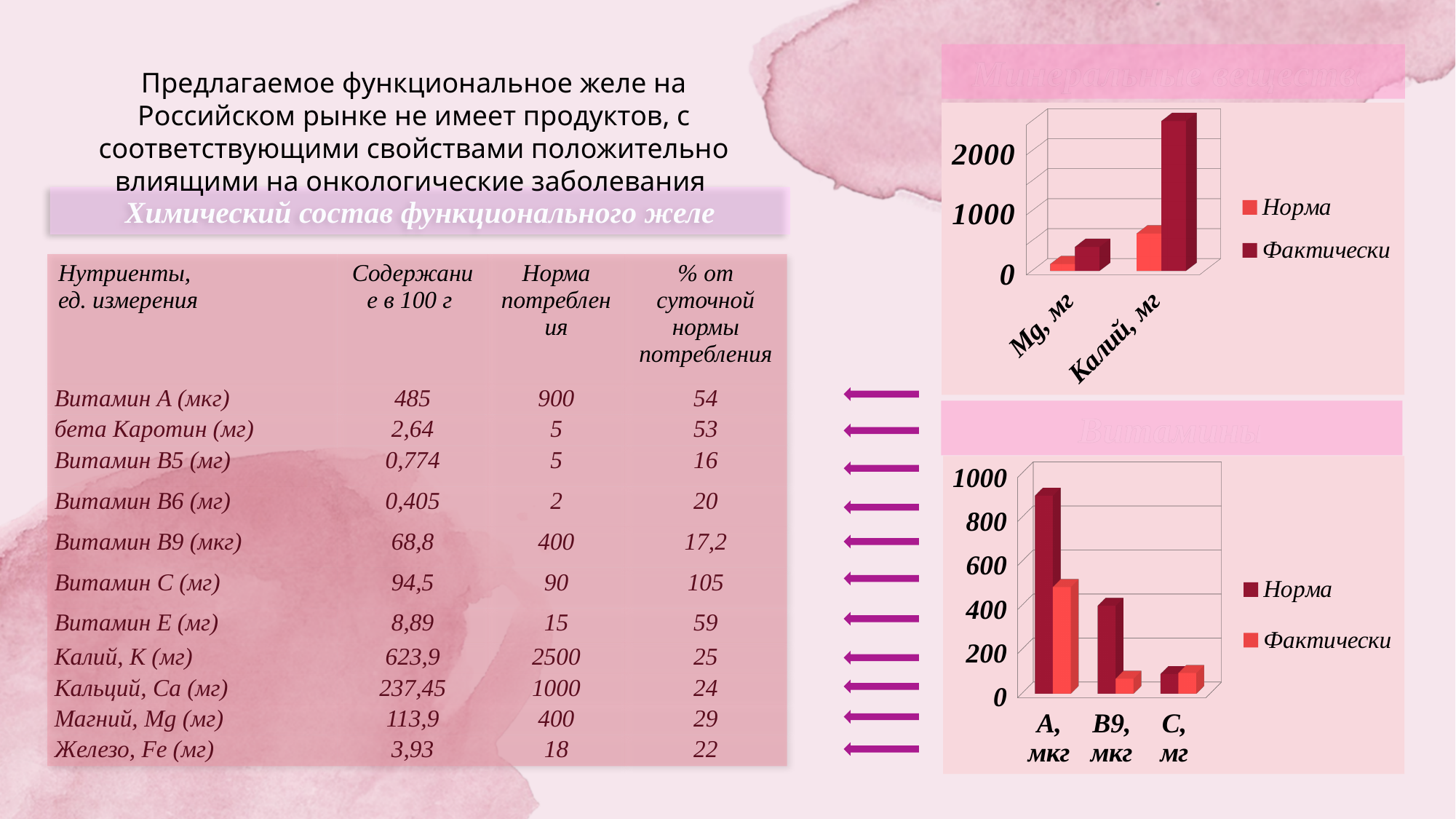
How many categories are shown on the x axis of the 'Минеральные вещества' chart? 2 In the 'Минеральные вещества' chart, is the 'Фактически' value for 'Калий, мг' greater or less than 2000? greater What are the two legend entries of the 'Витамины' chart? Норма and Фактически In the 'Витамины' chart, which category has the highest 'Норма' value? A, мкг In the 'Витамины' chart, is the 'Норма' value for 'A, мкг' greater or less than 800? greater How many series does the legend of the 'Витамины' chart list? 2 In the 'Минеральные вещества' chart, is the 'Фактически' value for 'Mg, мг' greater or less than 1000? less What kind of chart is the 'Минеральные вещества' chart? bar chart In the 'Минеральные вещества' chart, which category has the larger 'Фактически' value, 'Mg, мг' or 'Калий, мг'? Калий, мг How many series does the legend of the 'Минеральные вещества' chart list? 2 How many categories are shown on the x axis of the 'Витамины' chart? 3